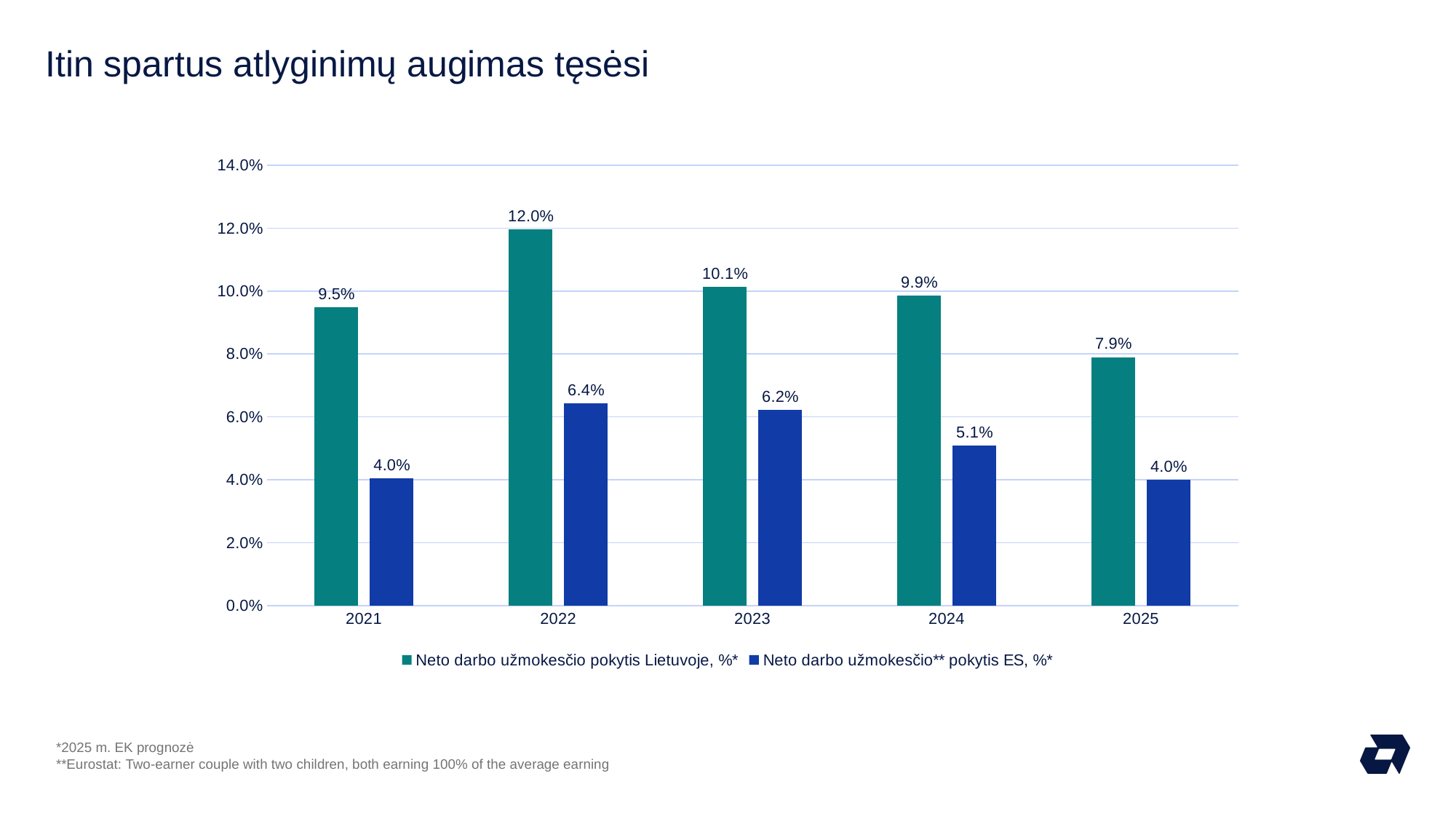
Does the EU series rise or fall from 2022 to 2025? Fall What is the value for Lithuania in 2025? 7.9% In which year is the Lithuania series lowest? 2025 Which is larger in 2021: the Lithuania value or the EU value? Lithuania What is the value for the EU (Neto darbo užmokesčio pokytis ES) in 2024? 5.1% Is the EU value for 2022 greater or less than 8.0%? less What kind of chart is shown on the slide? Bar chart How many series does the legend list? 2 In which year is the Lithuania series highest? 2022 How many years are shown on the x axis? 5 What is the difference between the Lithuania and EU values in 2023? 3.9% What is the value for Lithuania (Neto darbo užmokesčio pokytis Lietuvoje) in 2022? 12.0%